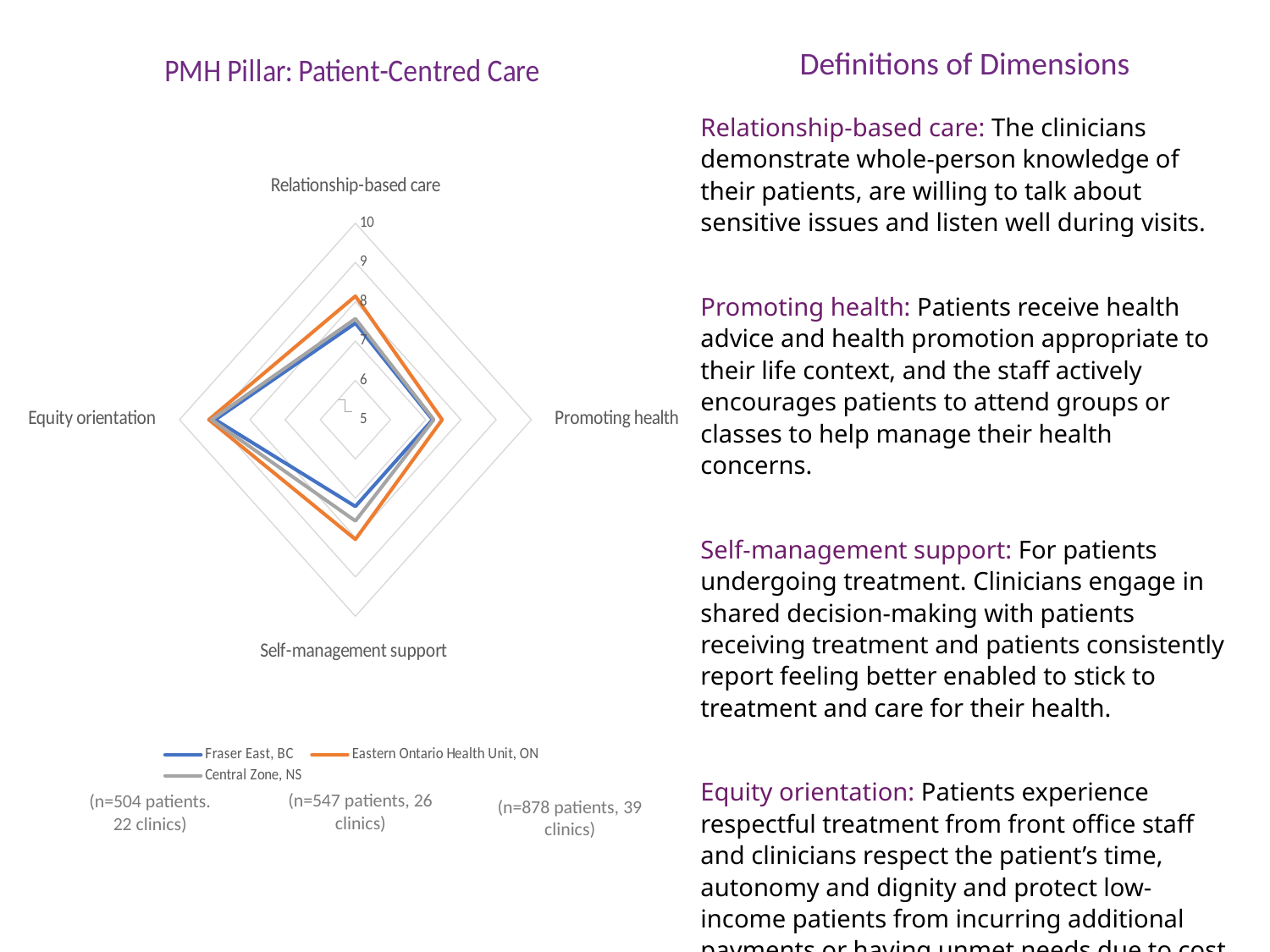
What is the title of the chart? PMH Pillar: Patient-Centred Care Is the Promoting health value for Fraser East, BC greater or less than 8? less On which dimension does Eastern Ontario Health Unit, ON score highest? Equity orientation Which series is drawn in orange in the chart? Eastern Ontario Health Unit, ON Is the Self-management support value for Fraser East, BC greater or less than 8? less For Self-management support, which series has the larger value: Fraser East, BC or Eastern Ontario Health Unit, ON? Eastern Ontario Health Unit, ON Is the Self-management support value for Eastern Ontario Health Unit, ON greater or less than 7? greater How many dimensions (axes) does the radar chart plot? 4 On which dimension does Eastern Ontario Health Unit, ON score lowest? Promoting health What kind of chart is shown on the slide? Radar chart How many series does the chart legend list? 3